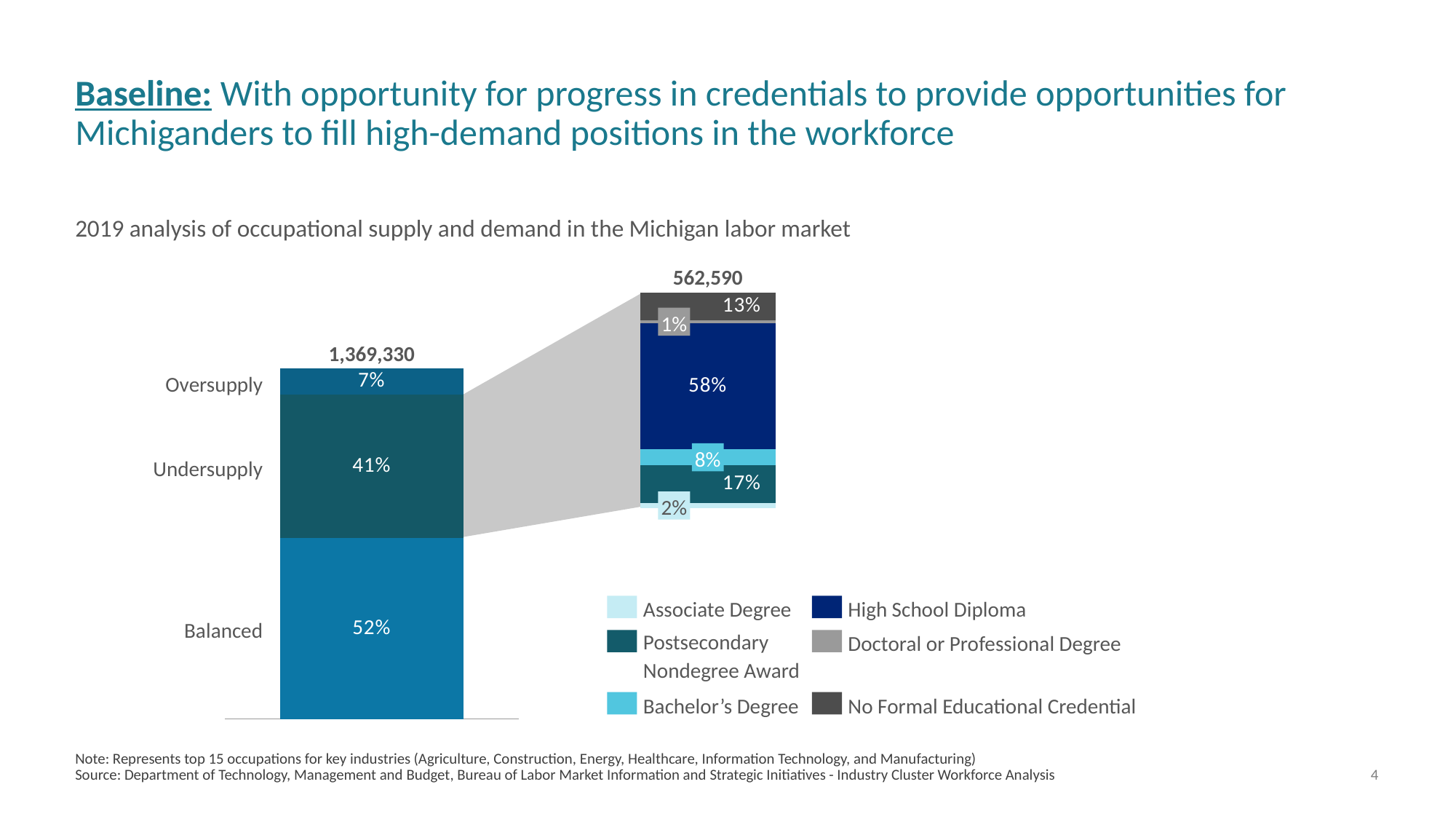
In the right stacked bar, what percentage is shown for Postsecondary Nondegree Award? 17% In the right stacked bar, what is the difference in percentage points between No Formal Educational Credential and Bachelor's Degree? 5 What total value is printed above the left stacked bar? 1,369,330 In the left stacked bar, what percentage is labelled for Undersupply? 41% How many credential categories does the legend list? 6 In the left stacked bar, what percentage is labelled for Oversupply? 7% In the right stacked bar, which credential category has the largest share? High School Diploma In the right stacked bar, which credential category has the smallest share? Doctoral or Professional Degree What kind of chart is shown on the slide? Stacked bar chart What total value is printed above the right stacked bar? 562,590 In the left stacked bar, what percentage is labelled for Balanced? 52% In the right stacked bar, what percentage is shown for High School Diploma? 58%